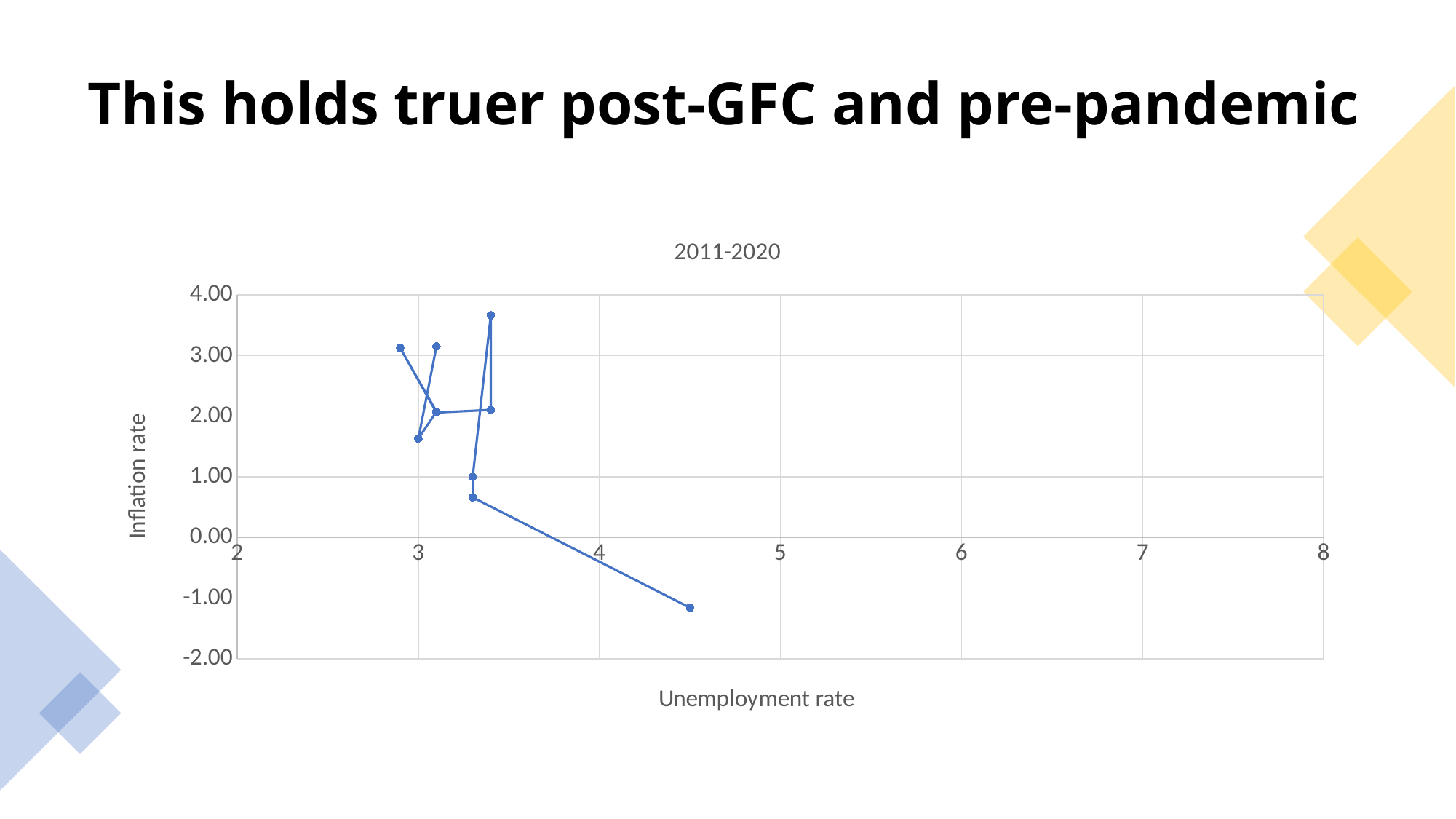
What is the title of the chart? 2011-2020 How many plotted points have an unemployment rate greater than 4? 1 Is the inflation rate of the rightmost point on the chart greater or less than 0.00? less Is the inflation rate of the leftmost point on the chart greater or less than 2.00? greater Is the lowest inflation rate plotted on the chart greater or less than 0.00? less What kind of chart is shown on the slide? scatter chart Which point has the higher inflation rate: the leftmost point or the rightmost point? the leftmost point What variable is plotted on the horizontal axis of the chart? Unemployment rate